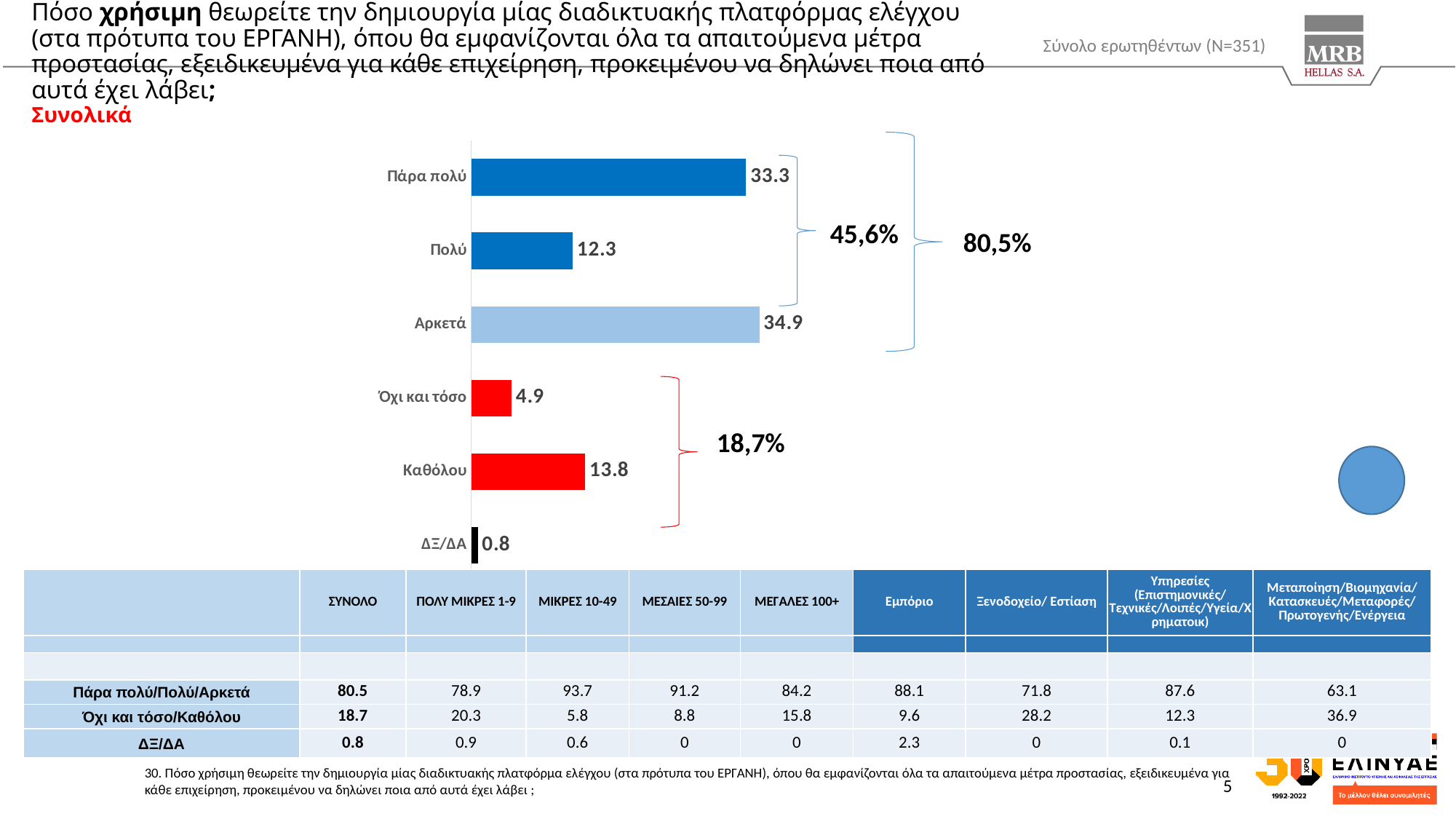
Which is larger, the value for Πολύ or the value for Καθόλου? Καθόλου What kind of chart is shown on the slide? Bar chart What is the value for Αρκετά? 34.9 How many categories are shown in the bar chart? 6 What is the value for Καθόλου? 13.8 Which category has the lowest value? ΔΞ/ΔΑ What is the value for ΔΞ/ΔΑ? 0.8 What combined percentage is shown by the bracket grouping Πάρα πολύ and Πολύ? 45,6% Which category has the highest value? Αρκετά What is the difference between the values for Καθόλου and Όχι και τόσο? 8.9 What is the difference between the values for Πάρα πολύ and Πολύ? 21.0 What is the value for Πάρα πολύ? 33.3